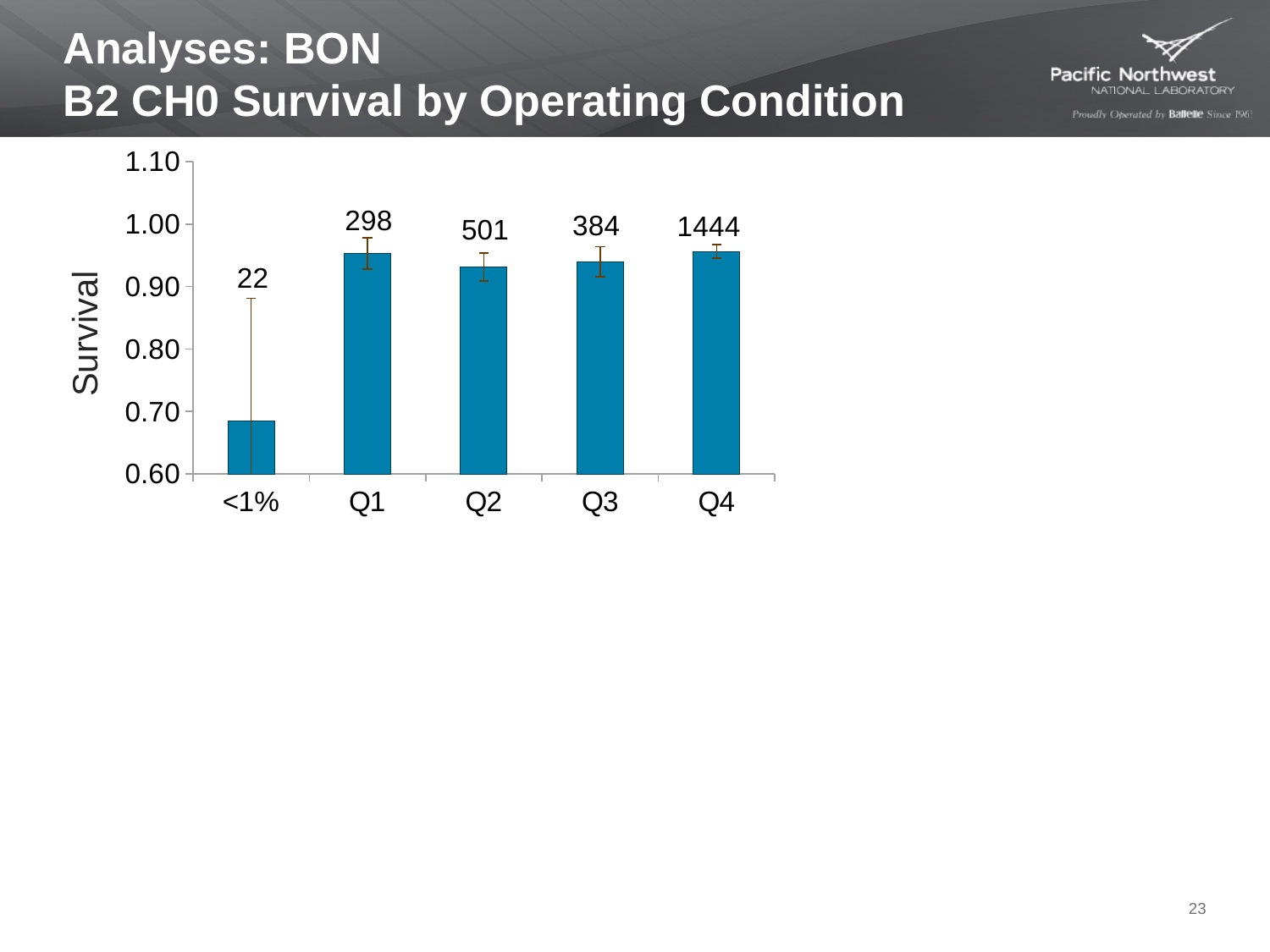
What is the label of the y axis? Survival Which has the higher survival bar, <1% or Q1? Q1 How many categories are shown on the x axis of the chart? 5 What number is printed above the bar for Q2? 501 Is the survival value for Q2 greater or less than 0.90? greater Is the survival value for Q4 greater or less than 1.00? less What number is printed above the bar for Q4? 1444 Is the survival value for <1% greater or less than 0.70? less What kind of chart is shown on the slide? bar chart Which category has the lowest survival bar? <1% What number is printed above the bar for <1%? 22